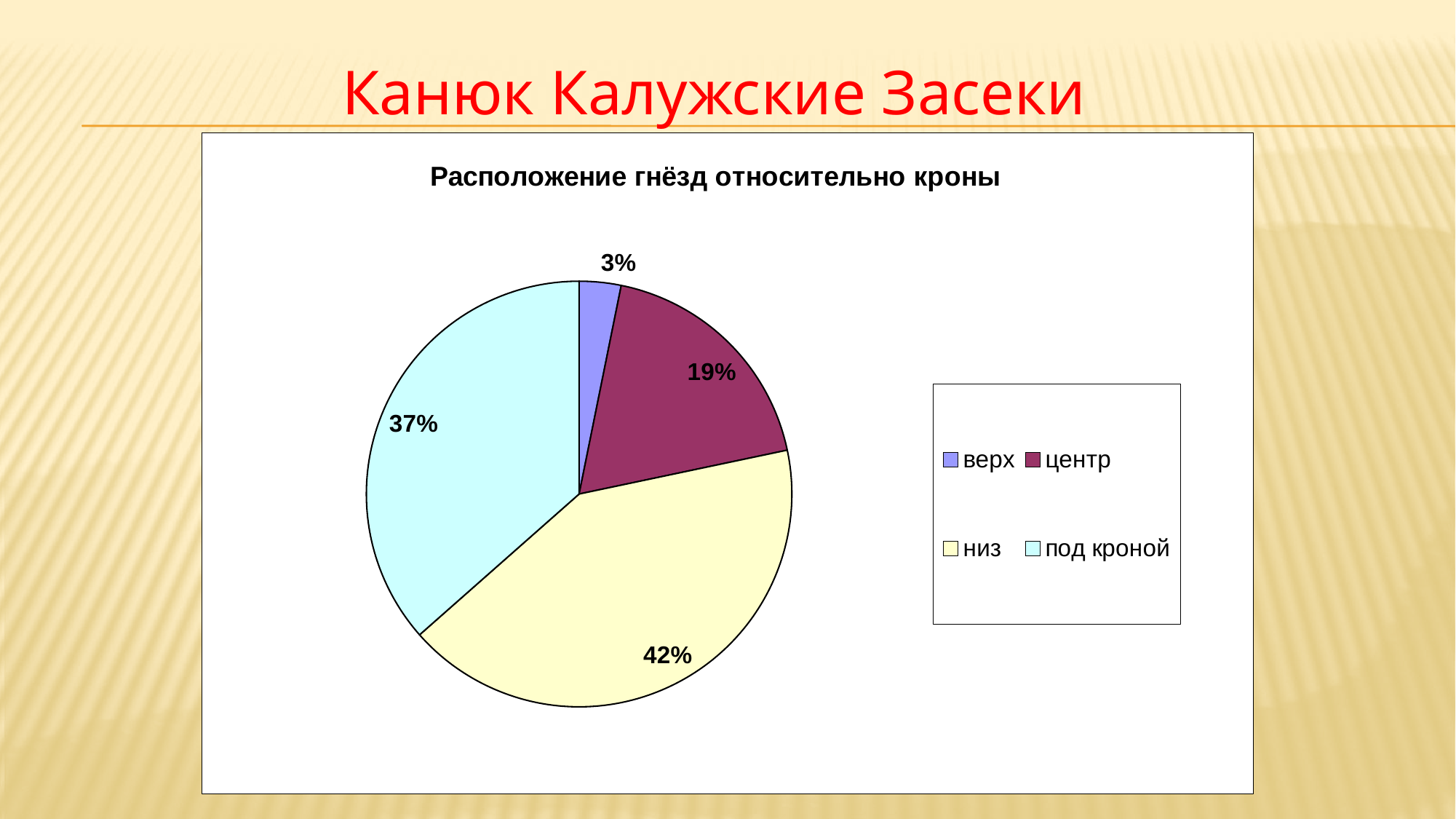
What share of the pie does the 'центр' slice represent? 19% Which category has the largest slice of the pie? низ What share of the pie does the 'верх' slice represent? 3% What type of chart is shown on the slide? pie chart Which is larger, the 'центр' slice or the 'под кроной' slice? под кроной What is the difference in percentage points between the 'низ' and 'под кроной' slices? 5% What share of the pie does the 'под кроной' slice represent? 37% What is the title of the chart? Расположение гнёзд относительно кроны Which category has the smallest slice of the pie? верх What colour is the 'под кроной' slice in the pie chart? light blue How many categories does the pie chart show? 4